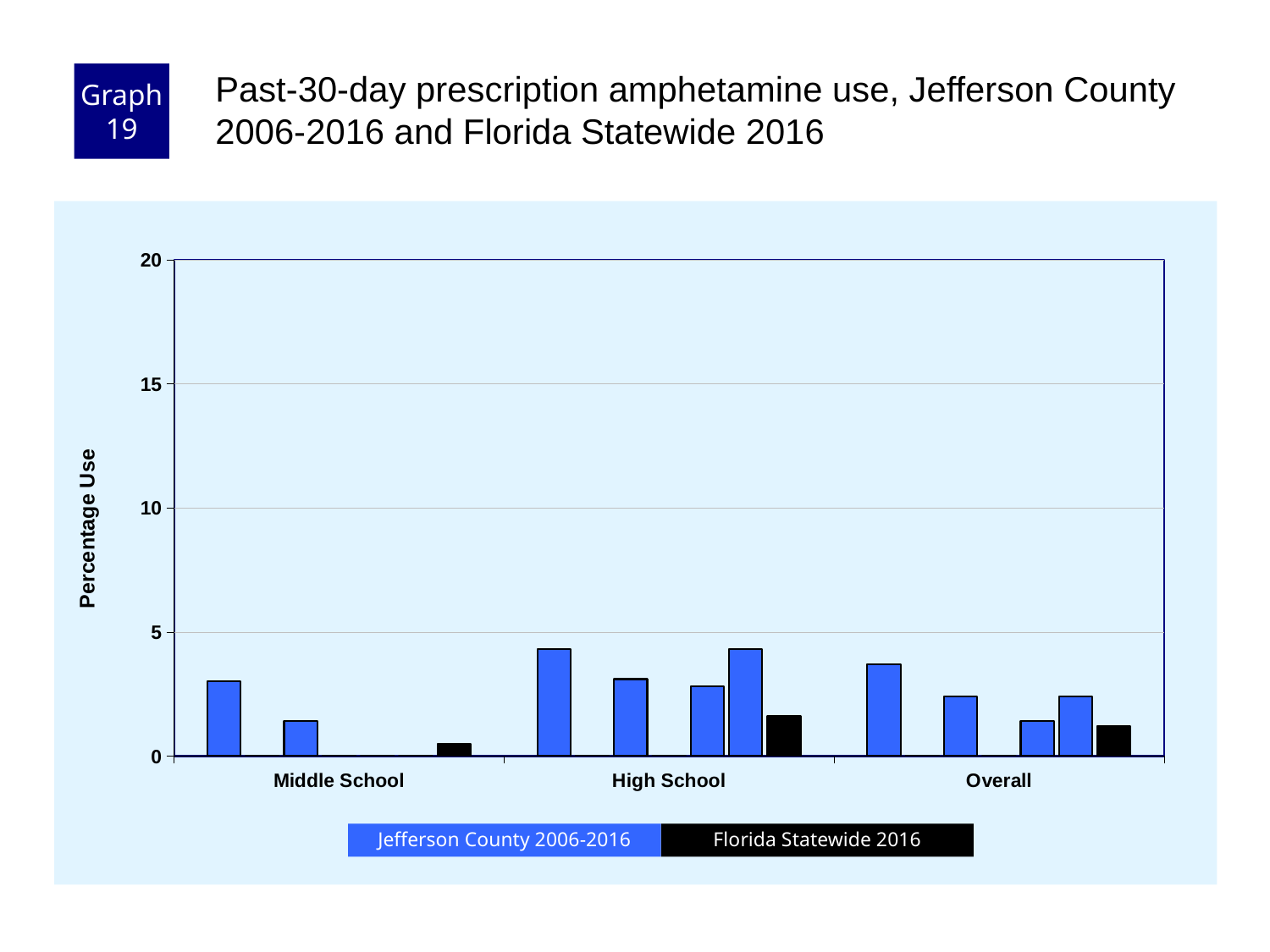
Which category has the highest Florida Statewide 2016 value? High School What is the title of the y axis? Percentage Use Which colour represents Florida Statewide 2016 in the legend? black Is the Florida Statewide 2016 value larger for High School or for Middle School? High School How many school-level categories are shown on the x axis? 3 Is the Florida Statewide 2016 value for High School greater or less than 5? less Is the Florida Statewide 2016 value larger for Overall or for Middle School? Overall What kind of chart is shown on the slide? bar chart Are any of the bars on the chart greater than 10? No Which category has the lowest Florida Statewide 2016 value? Middle School Is the Florida Statewide 2016 value for Middle School greater or less than 5? less How many series does the legend list? 2